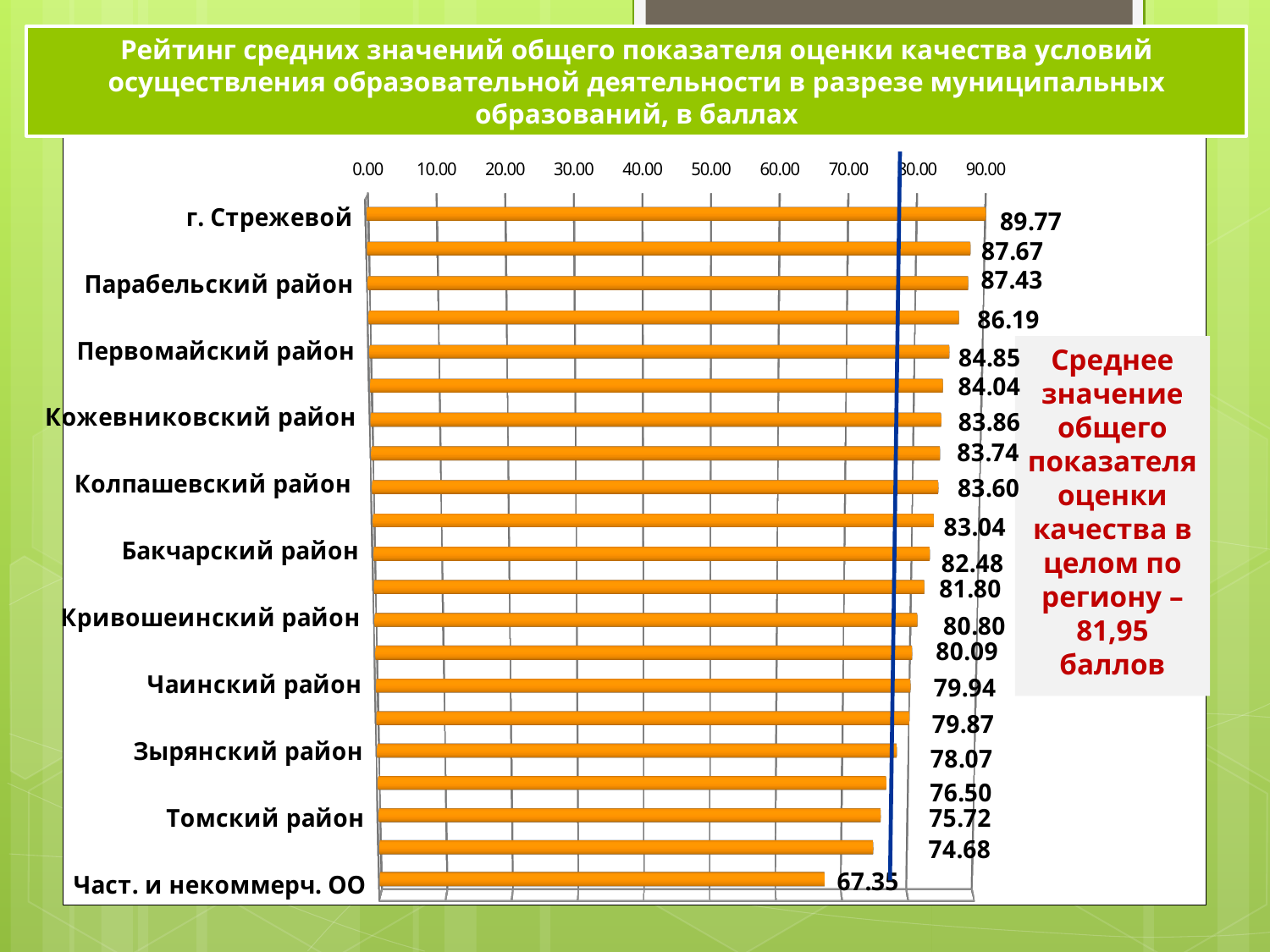
What is the difference between the values for г. Стрежевой and Част. и некоммерч. ОО? 22.42 What is the value for г. Стрежевой? 89.77 According to the text box on the slide, what is the average value of the overall quality indicator for the region as a whole? 81,95 баллов How many bars are plotted on the chart? 21 Which category has the highest value? г. Стрежевой What is the value for Парабельский район? 87.43 What is the value for Томский район? 75.72 Is the value for Чаинский район greater or less than 80.00? less Which category has the lowest value? Част. и некоммерч. ОО Which is larger, the value for Первомайский район or the value for Зырянский район? Первомайский район What is the value for Колпашевский район? 83.60 What kind of chart is shown on the slide? bar chart